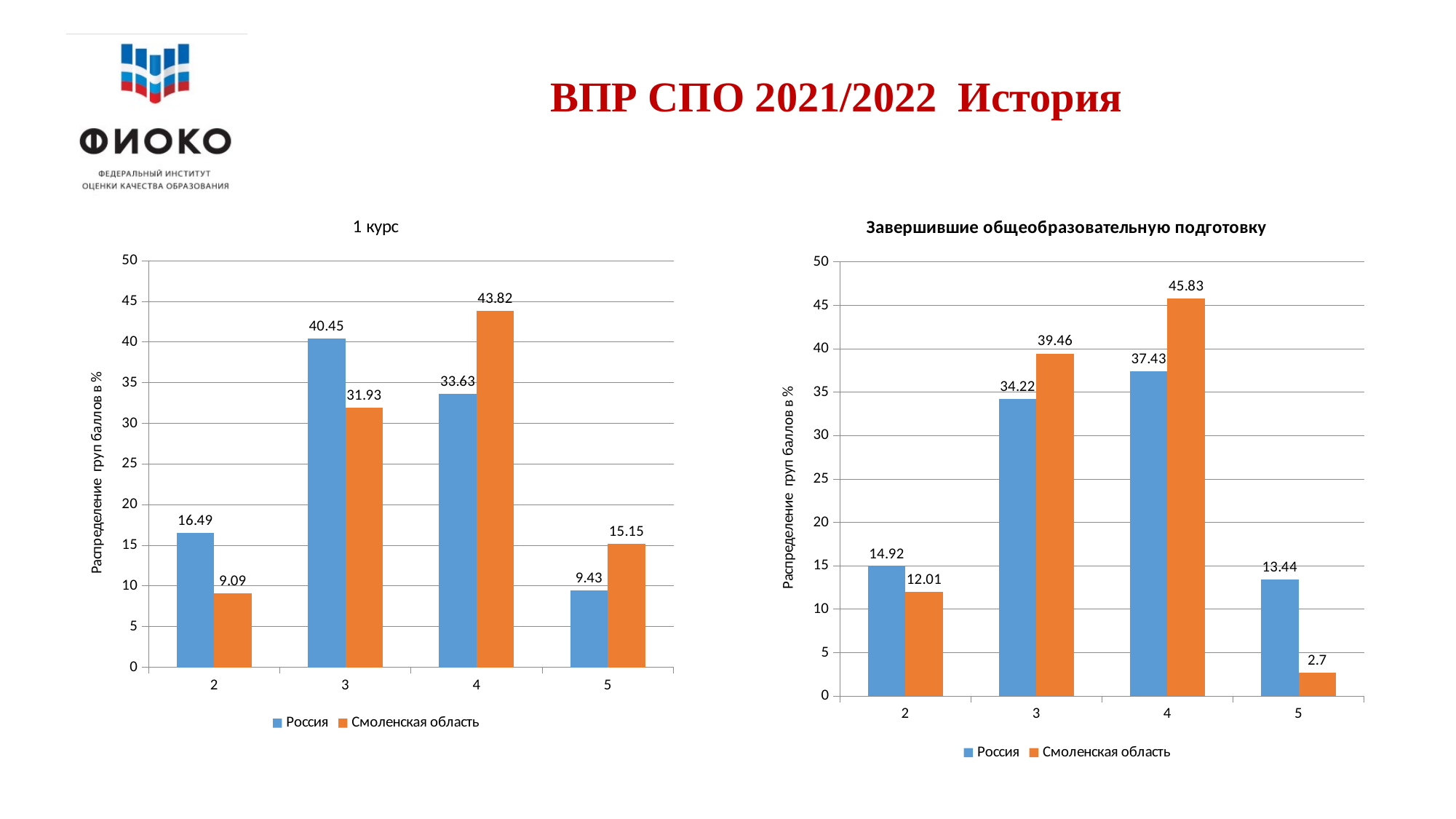
In the '1 курс' chart, what is the value for Россия at score group 3? 40.45 How many series does the legend of the 'Завершившие общеобразовательную подготовку' chart list? 2 In the 'Завершившие общеобразовательную подготовку' chart, which score group has the lowest value for Смоленская область? 5 In the '1 курс' chart, which score group has the lowest value for Россия? 5 In the 'Завершившие общеобразовательную подготовку' chart, what is the value for Россия at score group 4? 37.43 In the '1 курс' chart, which score group has the highest value for Смоленская область? 4 In the '1 курс' chart, what is the difference between Россия and Смоленская область at score group 2? 7.4 In the '1 курс' chart, which is larger at score group 5: Россия or Смоленская область? Смоленская область In the 'Завершившие общеобразовательную подготовку' chart, what is the value for Смоленская область at score group 5? 2.7 In the '1 курс' chart, what is the value for Смоленская область at score group 4? 43.82 What kind of chart is the '1 курс' chart? Bar chart In the 'Завершившие общеобразовательную подготовку' chart, what is the difference between Смоленская область and Россия at score group 3? 5.24